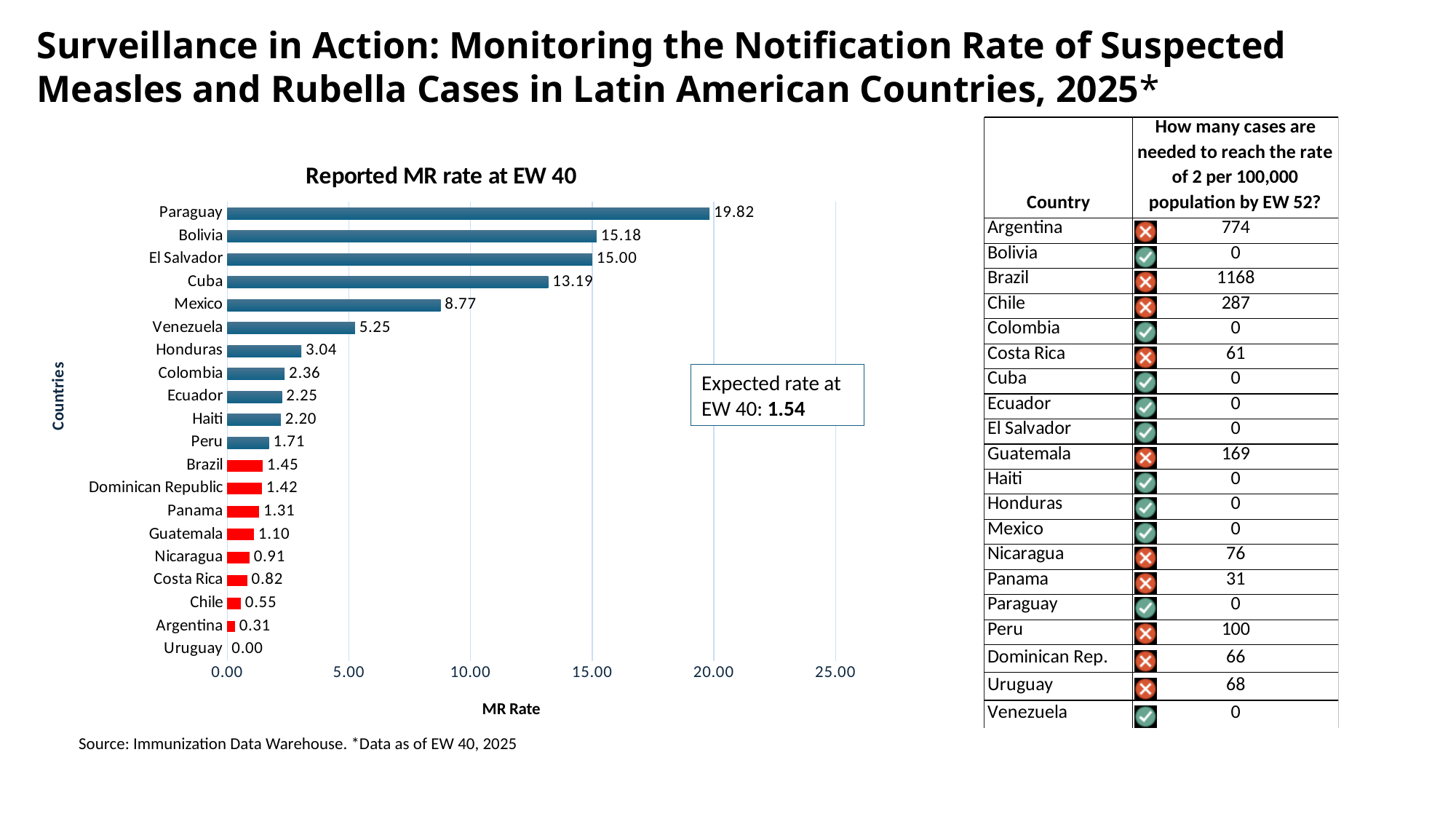
What is the expected rate at EW 40 shown in the text box on the chart? 1.54 How many countries are shown in the bar chart? 20 What is the reported MR rate at EW 40 for Guatemala? 1.10 What is the reported MR rate at EW 40 for Paraguay? 19.82 Which country has a higher MR rate, Cuba or Mexico? Cuba What is the title of the chart? Reported MR rate at EW 40 Which country has the lowest reported MR rate at EW 40? Uruguay What kind of chart is used to show the reported MR rate at EW 40? Bar chart Which country has the highest reported MR rate at EW 40? Paraguay What is the reported MR rate at EW 40 for Mexico? 8.77 What is the difference between the MR rates of Bolivia and El Salvador? 0.18 Is the MR rate for Venezuela greater or less than 5.00? greater